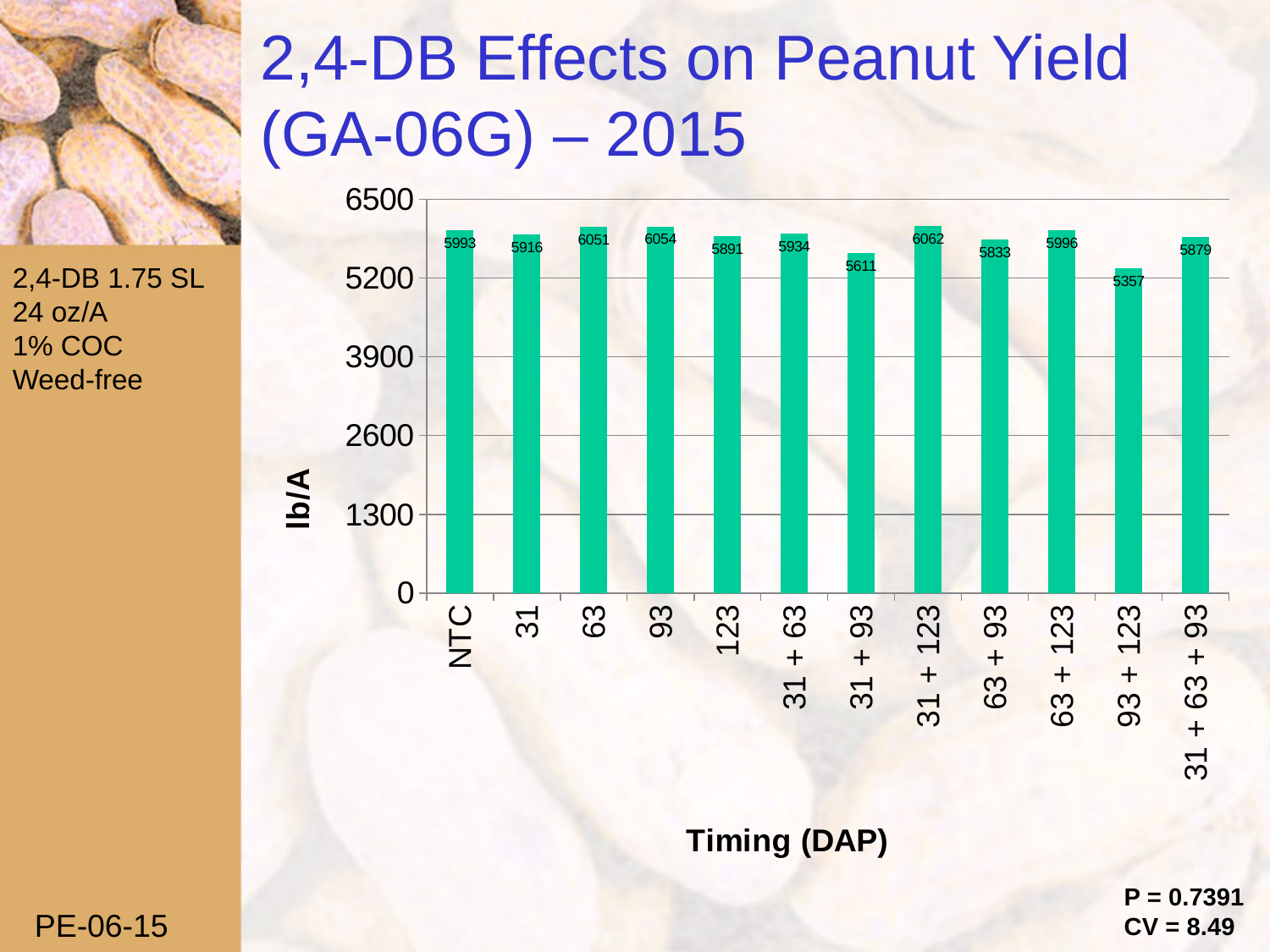
How many timing categories are shown on the x axis? 12 Which has the larger yield, the 123 timing or the 63 + 93 timing? 123 Which timing has the highest yield? 31 + 123 What is the yield (lb/A) for the 31 + 63 + 93 timing? 5879 What is the difference in yield between NTC and the 31 + 93 timing? 382 What is the difference in yield between the 63 timing and the 31 timing? 135 What is the yield (lb/A) for the 93 + 123 timing? 5357 What is the label of the y axis? lb/A Is the yield for the 93 + 123 timing greater or less than 5200? greater Which timing has the lowest yield? 93 + 123 What kind of chart is shown on the slide? bar chart What is the yield (lb/A) for the NTC treatment? 5993